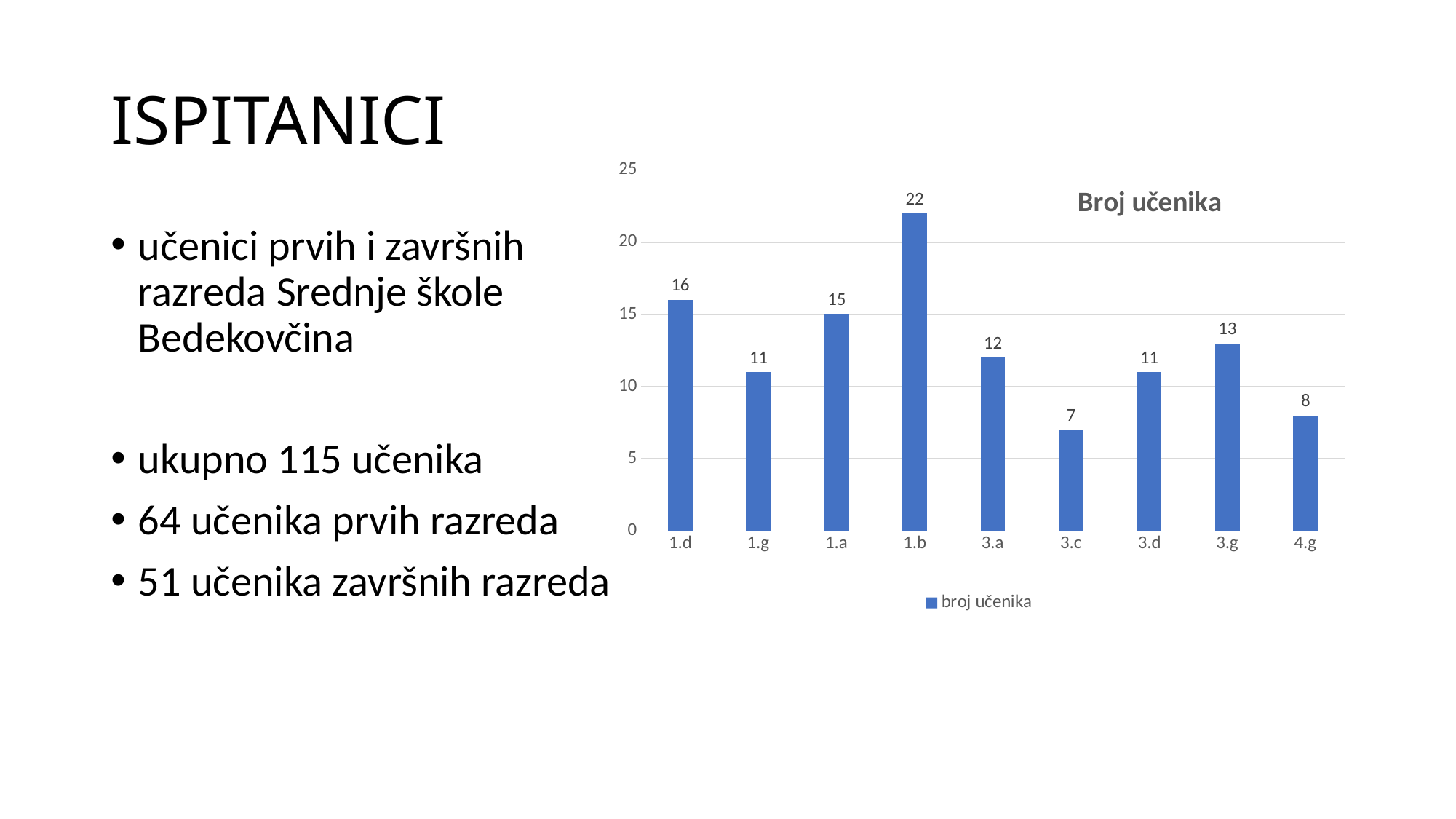
Which category has the highest value in the Broj učenika chart? 1.b What is the difference between the values for 3.g and 4.g? 5 Which is larger, the value for 1.a or the value for 3.a? 1.a What is the difference between the values for 1.b and 1.d? 6 How many categories are shown on the x axis of the chart? 9 What is the value for 1.b in the Broj učenika chart? 22 What kind of chart is shown on the slide? bar chart How many series does the chart legend list? 1 Is the value for 1.d greater or less than 15? greater Which category has the lowest value in the Broj učenika chart? 3.c What is the value for 4.g in the Broj učenika chart? 8 What is the value for 3.c in the Broj učenika chart? 7